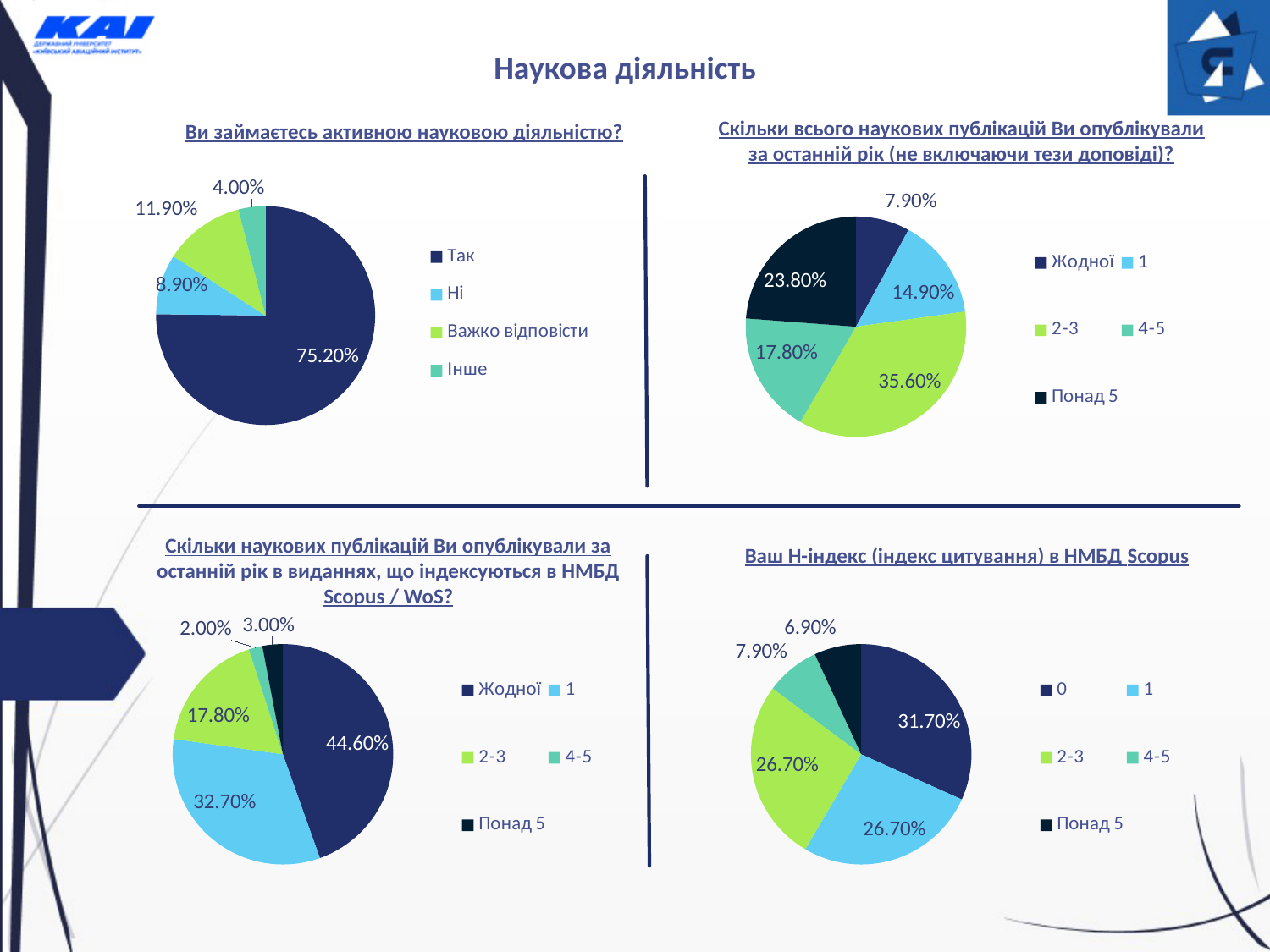
In the bottom-right chart 'Ваш H-індекс (індекс цитування) в НМБД Scopus', what share of respondents have an H-index of 0? 31.70% In the top-left chart 'Ви займаєтесь активною науковою діяльністю?', which answer has the smallest share? Інше In the top-right chart about total scientific publications in the last year, which is larger: the share for 'Понад 5' or for '1'? Понад 5 What type of chart is used for the four charts on this slide? Pie chart How many categories does the legend of the top-right chart about total scientific publications list? 5 In the bottom-right chart 'Ваш H-індекс (індекс цитування) в НМБД Scopus', what is the difference between the shares for '4-5' and 'Понад 5'? 1.00% In the top-left chart 'Ви займаєтесь активною науковою діяльністю?', what is the difference between the shares for 'Важко відповісти' and 'Ні'? 3.00% In the bottom-left chart about publications in Scopus / WoS-indexed journals, which answer has the smallest share? 4-5 In the top-left chart 'Ви займаєтесь активною науковою діяльністю?', what share of respondents answered 'Так'? 75.20% In the top-right chart about total scientific publications in the last year, what share of respondents chose '2-3'? 35.60% In the top-right chart about total scientific publications in the last year, which answer has the largest share? 2-3 In the bottom-left chart about publications in Scopus / WoS-indexed journals, what share of respondents answered 'Жодної'? 44.60%